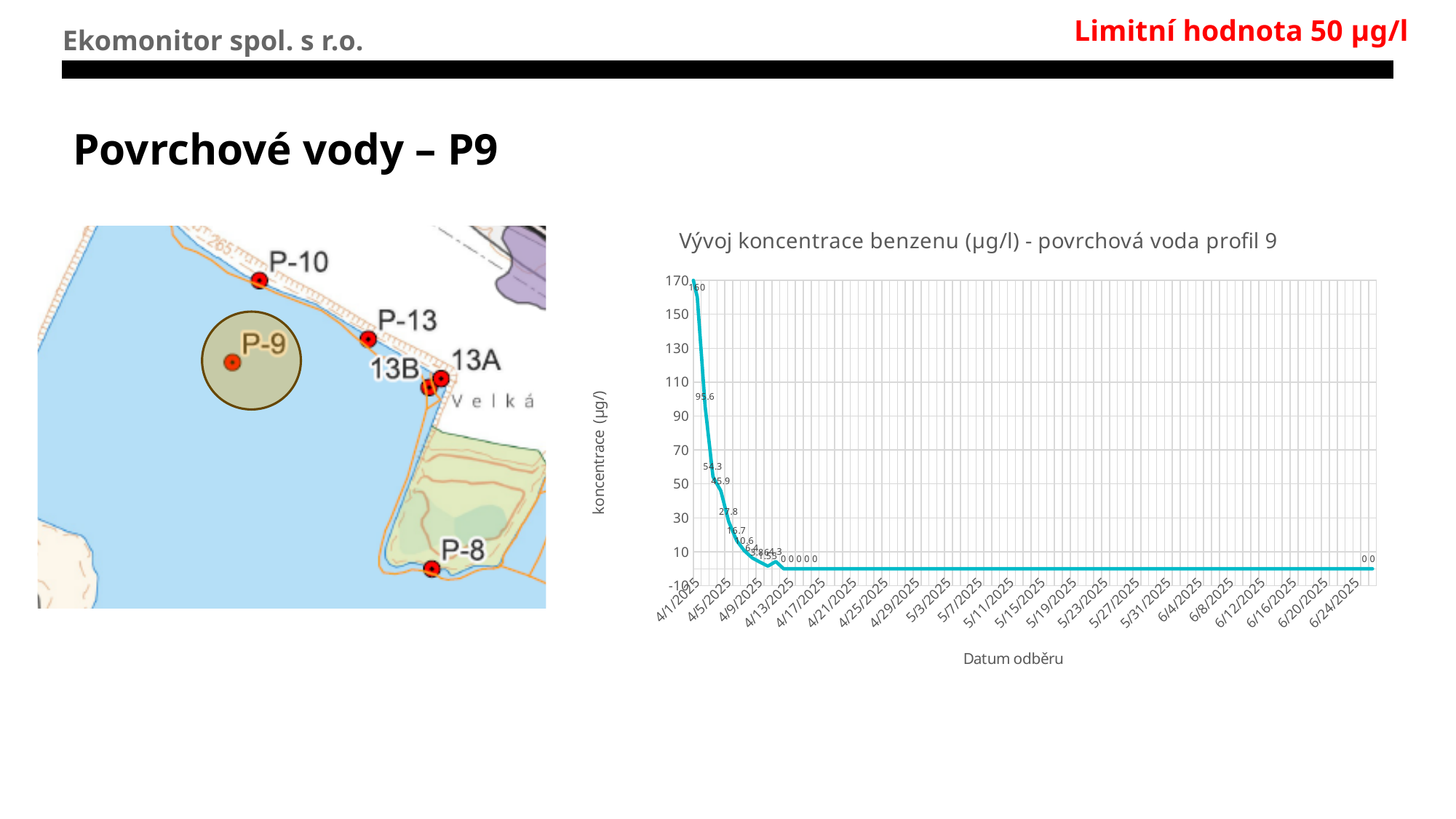
What kind of chart is shown on the slide? line chart How many lines (data series) are plotted on the chart? 1 What is the benzene concentration value plotted for 4/1/2025? 160 What is the title of the chart? Vývoj koncentrace benzenu (µg/l) - povrchová voda profil 9 Do the values rise or fall along the x axis from 4/1/2025 onward? fall What is the lowest value labeled on the line? 0 Is the value for 4/1/2025 greater or less than 150? greater What is the difference between the first two labeled values on the line, 160 and 95.6? 64.4 What is the highest value labeled on the line? 160 What is the label of the vertical axis of the chart? koncentrace (µg/l)